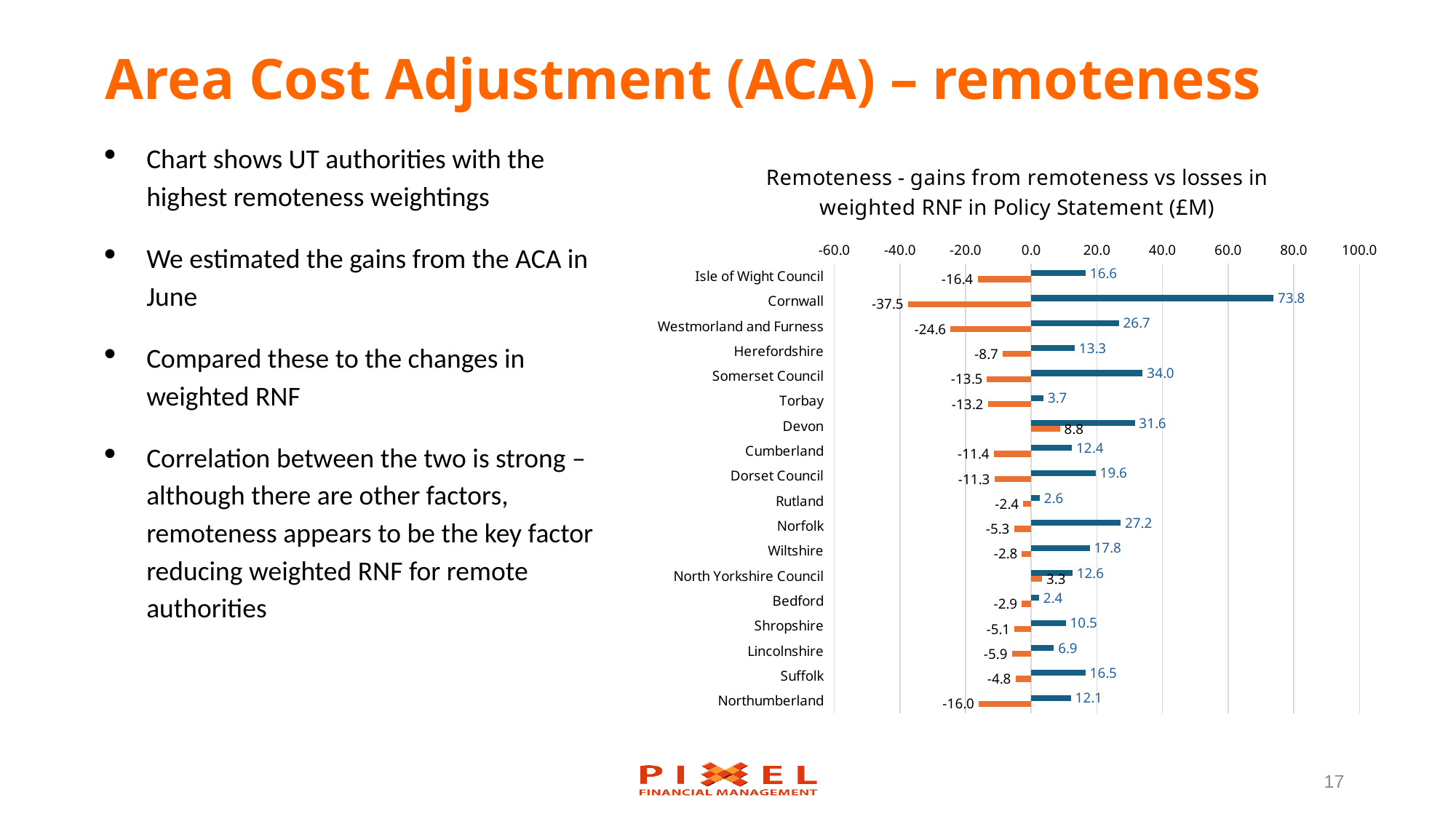
What is the difference between the blue values for Cornwall and Somerset Council? 39.8 What type of chart is shown on the slide? bar chart What is the blue value for Somerset Council? 34.0 Which authority has the most negative orange (losses) value? Cornwall Which authority has the highest blue (gains) value? Cornwall Which has a larger blue value, Norfolk or Westmorland and Furness? Norfolk What is the blue (gains) value for Cornwall? 73.8 What is the orange value for Northumberland? -16.0 What is the orange (losses) value for Westmorland and Furness? -24.6 Which authority has the lowest blue (gains) value? Bedford What is the title of the chart? Remoteness - gains from remoteness vs losses in weighted RNF in Policy Statement (£M) How many authorities are listed on the chart? 18